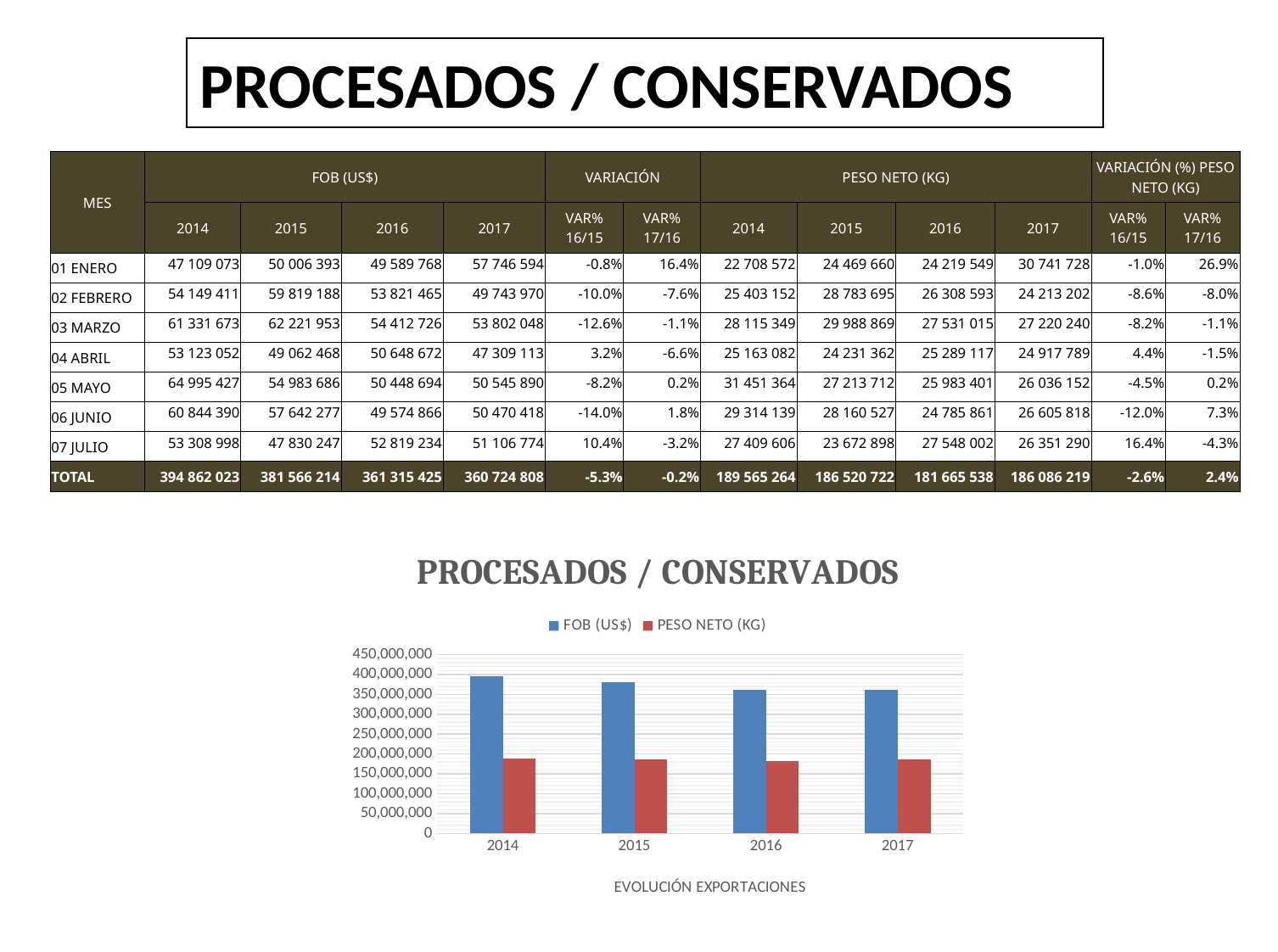
Which colour represents the PESO NETO (KG) series in the chart? red Which year has the highest FOB (US$) value in the chart? 2014 What kind of chart is shown on the slide? bar chart Is the PESO NETO (KG) value for 2016 greater or less than 150,000,000? greater How many series does the chart legend list? 2 Do the FOB (US$) values rise or fall from 2014 to 2017? fall Which series has the larger value in 2015, FOB (US$) or PESO NETO (KG)? FOB (US$) How many years are shown on the x axis of the chart? 4 Is the FOB (US$) value for 2014 greater or less than 350,000,000? greater What is the title of the chart? PROCESADOS / CONSERVADOS Is the FOB (US$) value for 2017 greater or less than 400,000,000? less